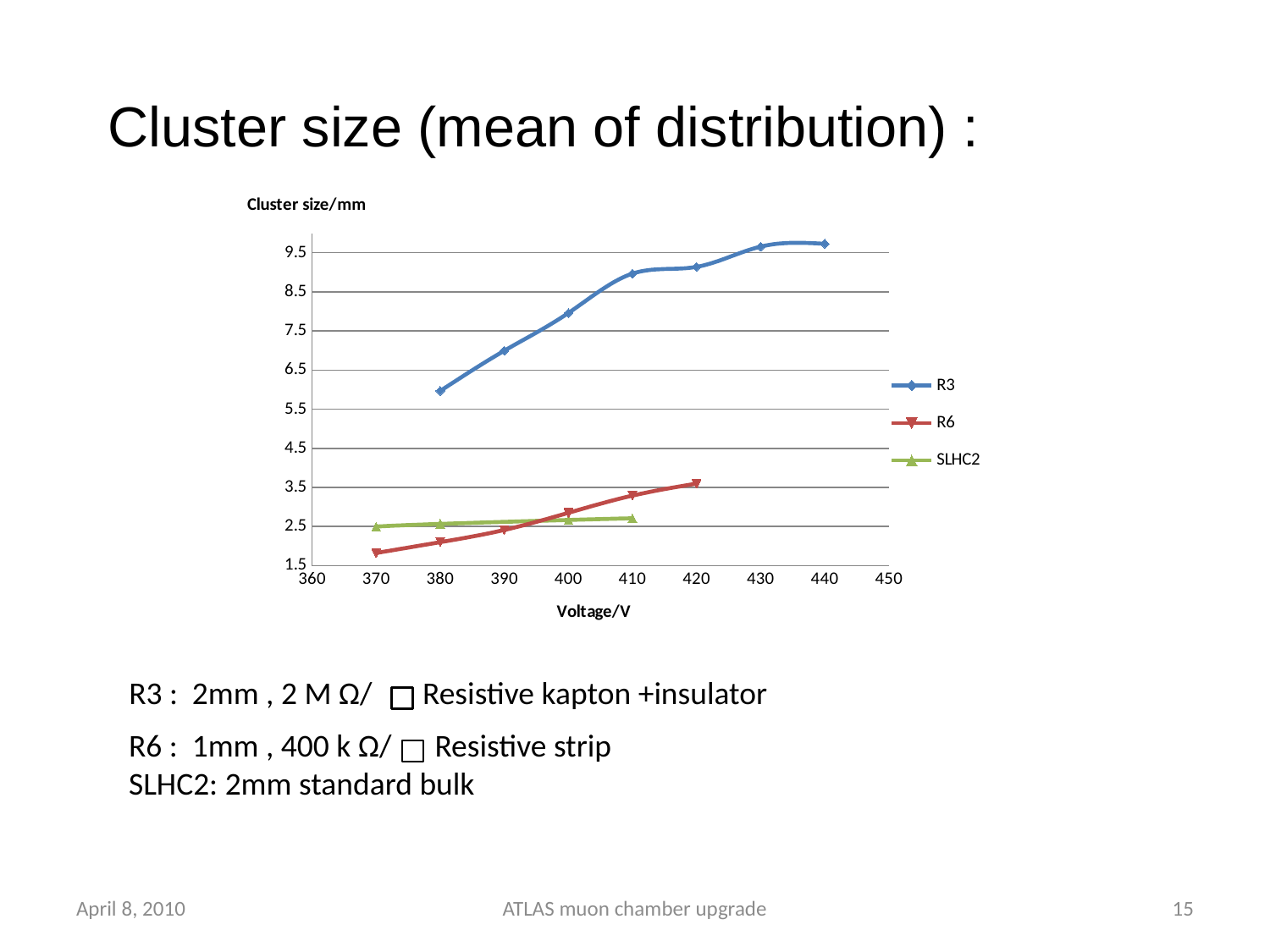
What is the label of the x axis? Voltage/V How many data points are plotted for the R3 series? 7 Which series reaches the highest cluster size on the chart? R3 Is the value for R3 at 380 V greater or less than 6.5? less How many series does the legend list? 3 Does the cluster size for R3 rise or fall as the voltage increases? rise Does the cluster size for R6 rise or fall as the voltage increases? rise Is the value for R3 at 410 V greater or less than 8.5? greater What are the names of the series listed in the legend? R3, R6, SLHC2 At 410 V, which series has the larger cluster size, R6 or SLHC2? R6 What kind of chart is shown on the slide? line chart Is the value for R6 at 370 V greater or less than 2.5? less